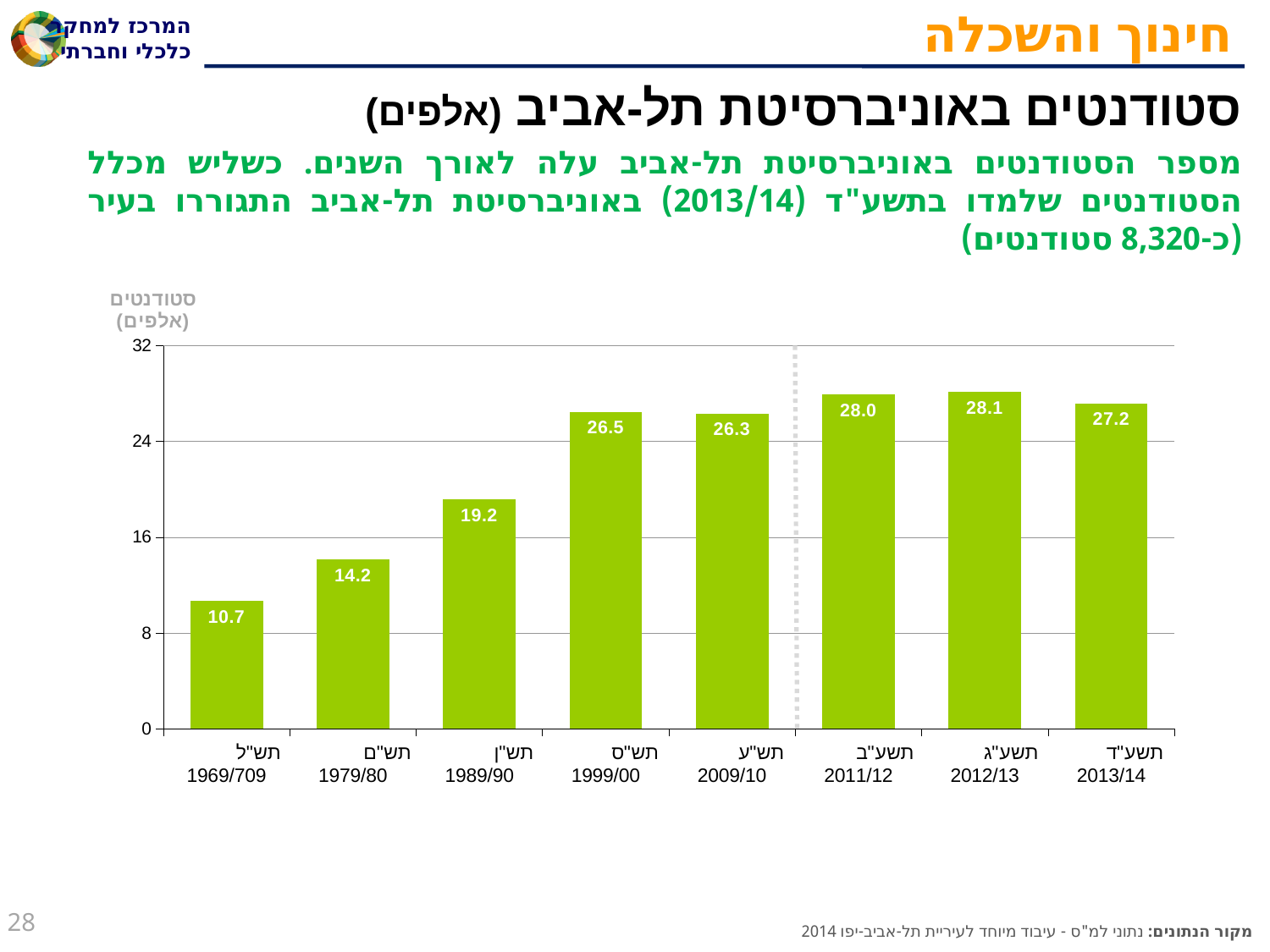
Do the values generally rise or fall from 1969/709 to 1999/00? rise What is the value for the first bar, labelled 1969/709? 10.7 Which year has the lowest value? 1969/709 What is the difference between the values for 1989/90 and 1979/80? 5.0 What is the value for 1999/00? 26.5 Which year has the highest value? 2012/13 Which is larger, the value for 1999/00 or the value for 2009/10? 1999/00 Is the value for 2011/12 greater or less than 24? greater What is the difference between the values for 2012/13 and 2013/14? 0.9 What is the value for 2013/14? 27.2 How many bars are shown in the chart? 8 What kind of chart is shown on the slide? bar chart